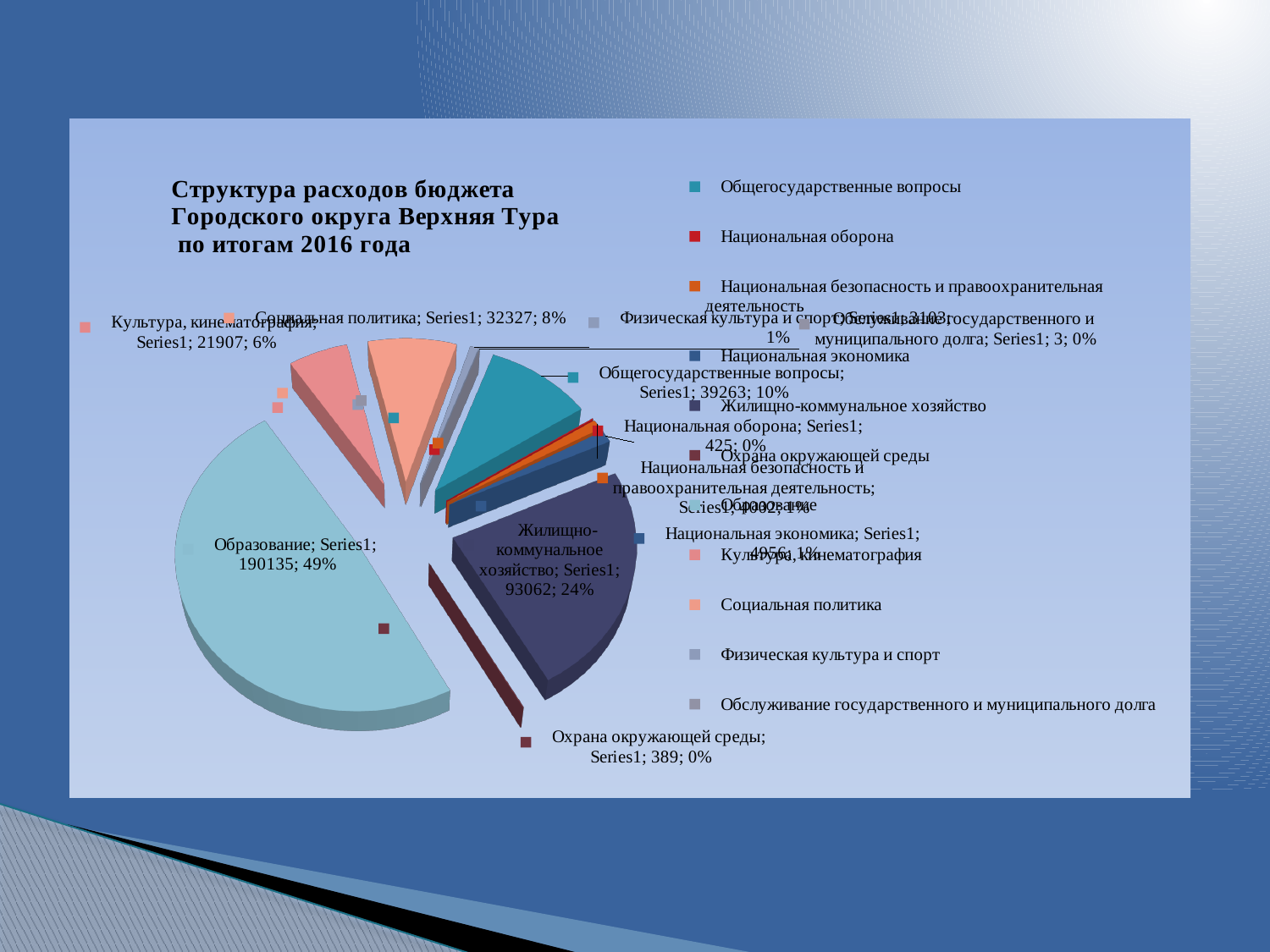
What is the value shown for Жилищно-коммунальное хозяйство? 93062 What percentage share of the pie does Культура, кинематография have? 6% What is the difference between the values for Образование and Жилищно-коммунальное хозяйство? 97073 Which category has the largest share of the pie? Образование How many categories does the legend list? 11 What kind of chart is shown on the slide? pie chart What percentage share of the pie does Жилищно-коммунальное хозяйство have? 24% Which category has the smallest value in the pie chart? Обслуживание государственного и муниципального долга What is the value shown for Образование? 190135 What is the value shown for Социальная политика? 32327 Which is larger, the value for Национальная оборона or the value for Охрана окружающей среды? Национальная оборона What is the value shown for Общегосударственные вопросы? 39263